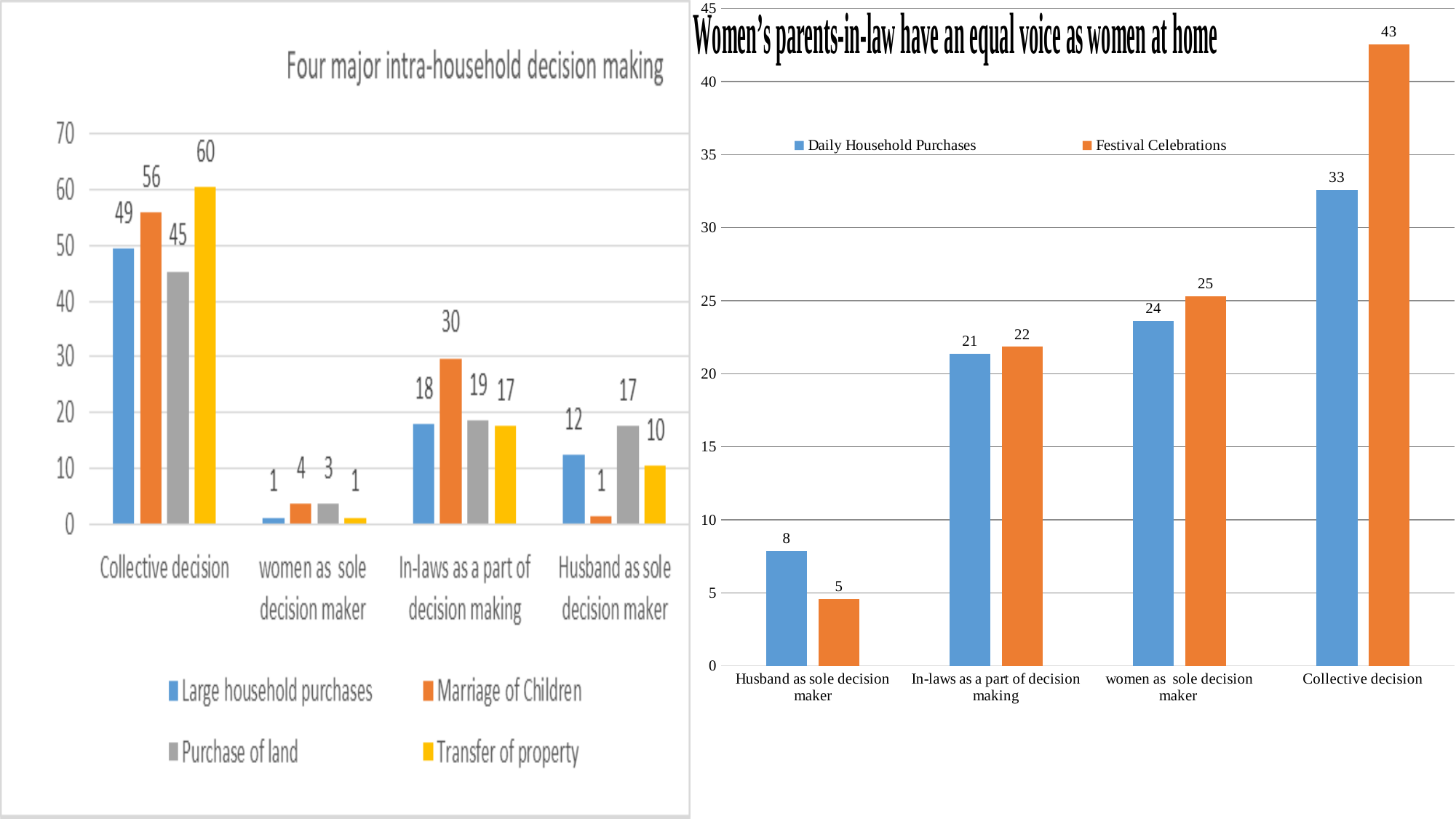
In the 'Four major intra-household decision making' chart, what is the value for Transfer of property under Collective decision? 60 In the 'Four major intra-household decision making' chart, what is the difference between Transfer of property and Large household purchases under Collective decision? 11 In the 'Women's parents-in-law have an equal voice as women at home' chart, what is the difference between Festival Celebrations and Daily Household Purchases under Collective decision? 10 What kind of chart is the 'Women's parents-in-law have an equal voice as women at home' chart? bar chart In the 'Four major intra-household decision making' chart, what is the value for Marriage of Children under In-laws as a part of decision making? 30 In the 'Women's parents-in-law have an equal voice as women at home' chart, do the Daily Household Purchases values rise or fall from left to right along the x axis? rise In the 'Women's parents-in-law have an equal voice as women at home' chart, what is the value for Festival Celebrations under Collective decision? 43 In the 'Four major intra-household decision making' chart, how many categories are shown on the x axis? 4 In the 'Women's parents-in-law have an equal voice as women at home' chart, what is the value for Daily Household Purchases under Husband as sole decision maker? 8 In the 'Women's parents-in-law have an equal voice as women at home' chart, which category has the lowest Festival Celebrations value? Husband as sole decision maker In the 'Four major intra-household decision making' chart, which series has the highest value under Husband as sole decision maker? Purchase of land In the 'Four major intra-household decision making' chart, how many series does the legend list? 4